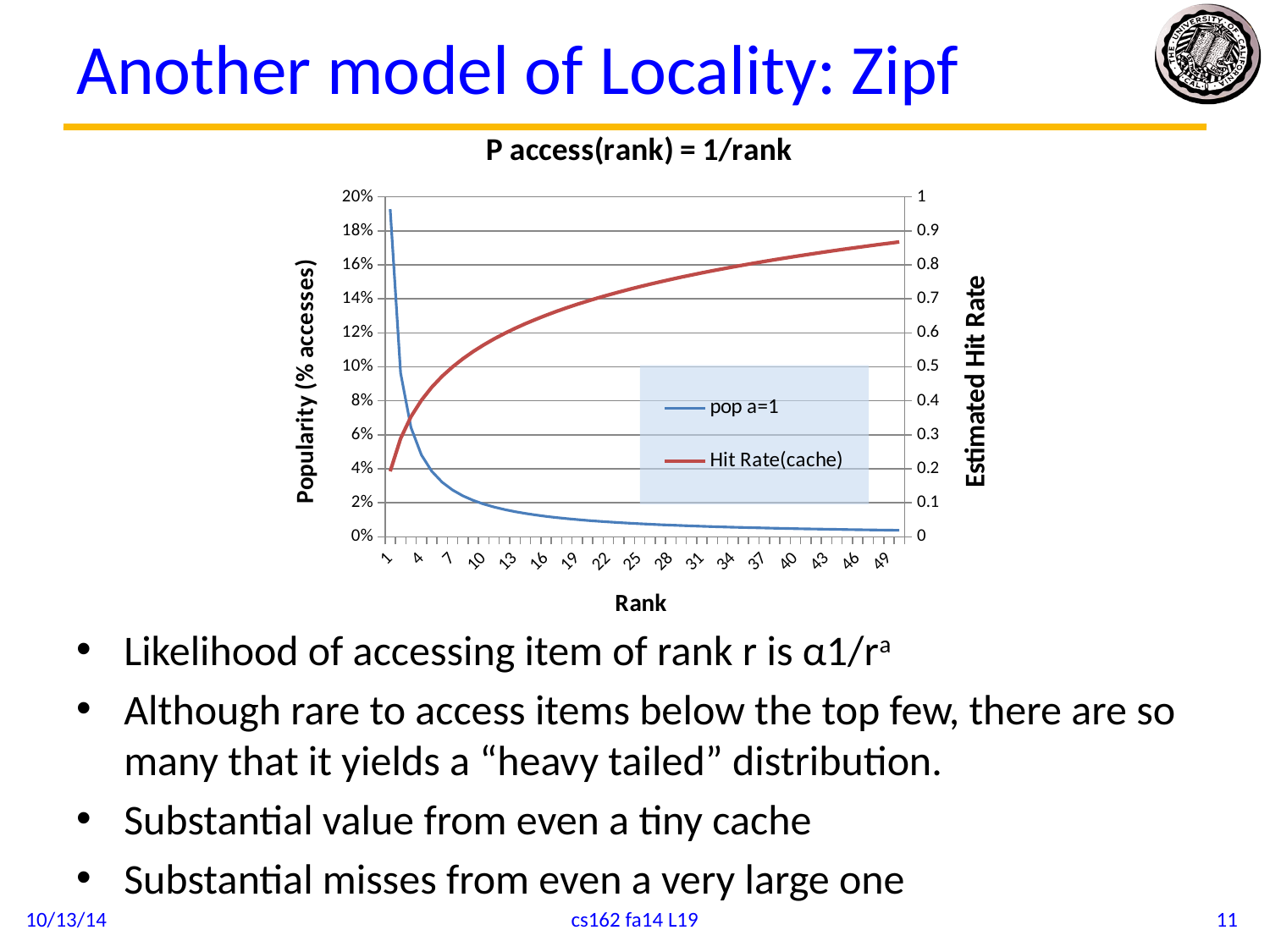
Is the value of 'Hit Rate(cache)' at rank 49 greater or less than 0.8? greater Does the 'pop a=1' series rise or fall as rank increases? fall What is the label of the x axis of the chart? Rank Does the 'Hit Rate(cache)' series rise or fall as rank increases? rise Is the value of 'pop a=1' at rank 1 greater or less than 10%? greater Is the value of 'Hit Rate(cache)' at rank 10 greater or less than 0.5? greater How many series does the chart legend list? 2 Which series is plotted in red? Hit Rate(cache) What kind of chart is shown on the slide? line chart What is the title of the chart? P access(rank) = 1/rank